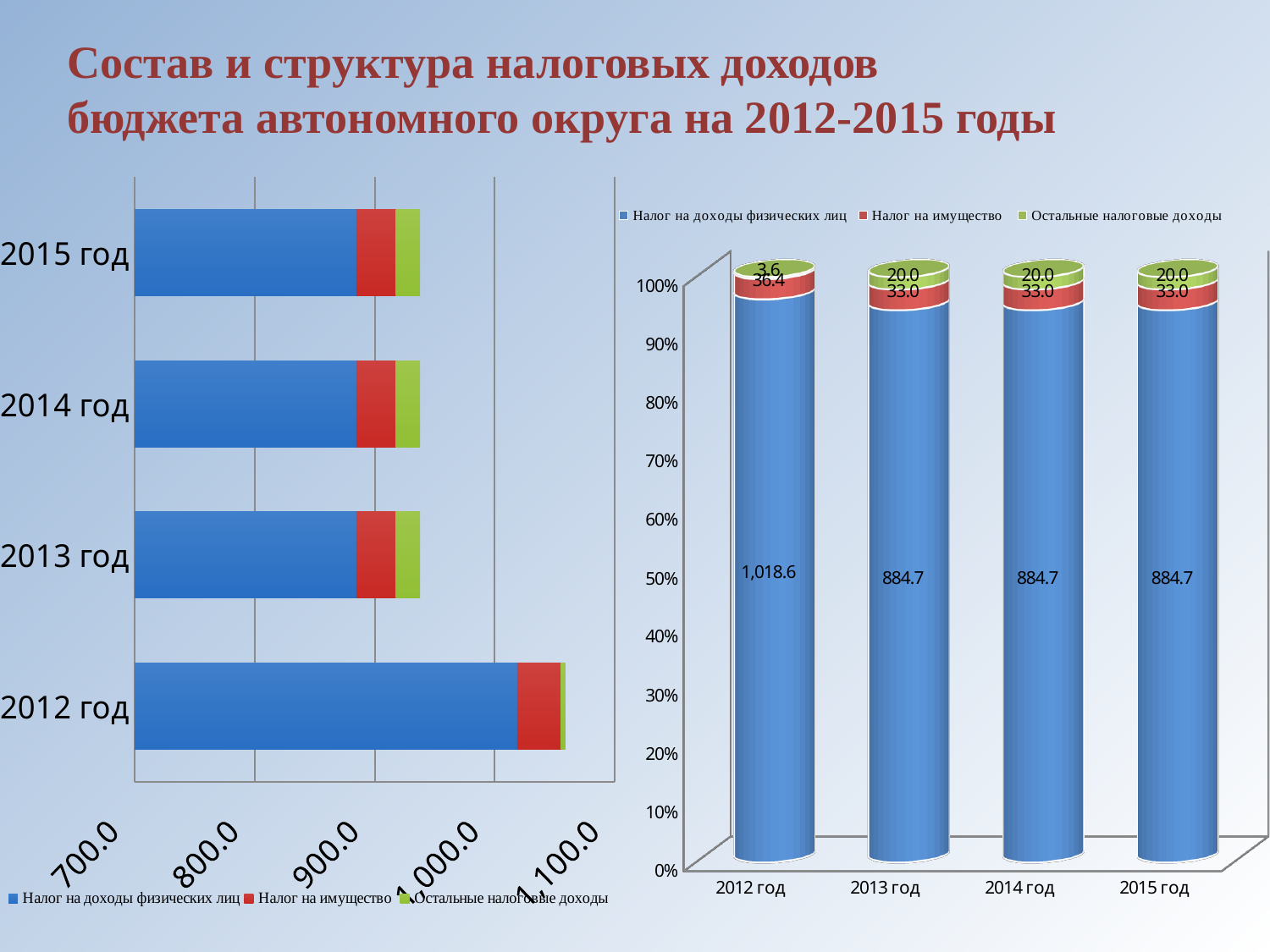
In the right chart, what colour represents Налог на имущество? red In the right chart, what is the value of Налог на доходы физических лиц for 2012 год? 1,018.6 In the right chart, what is the total of the three values shown for 2013 год? 937.7 How many years are shown on the left chart? 4 How many series does the legend of the right chart list? 3 In the right chart, what is the difference between the Налог на доходы физических лиц values for 2012 год and 2013 год? 133.9 What kind of chart is the left chart? bar chart In the right chart, what is the value of Остальные налоговые доходы for 2012 год? 3.6 In the right chart, what is the value of Налог на имущество for 2013 год? 33.0 In the left chart, is the value of Налог на доходы физических лиц for 2012 год greater or less than 1,000.0? greater In the right chart, which is larger: Остальные налоговые доходы for 2012 год or for 2015 год? 2015 год In the right chart, which year has the highest value for Налог на доходы физических лиц? 2012 год